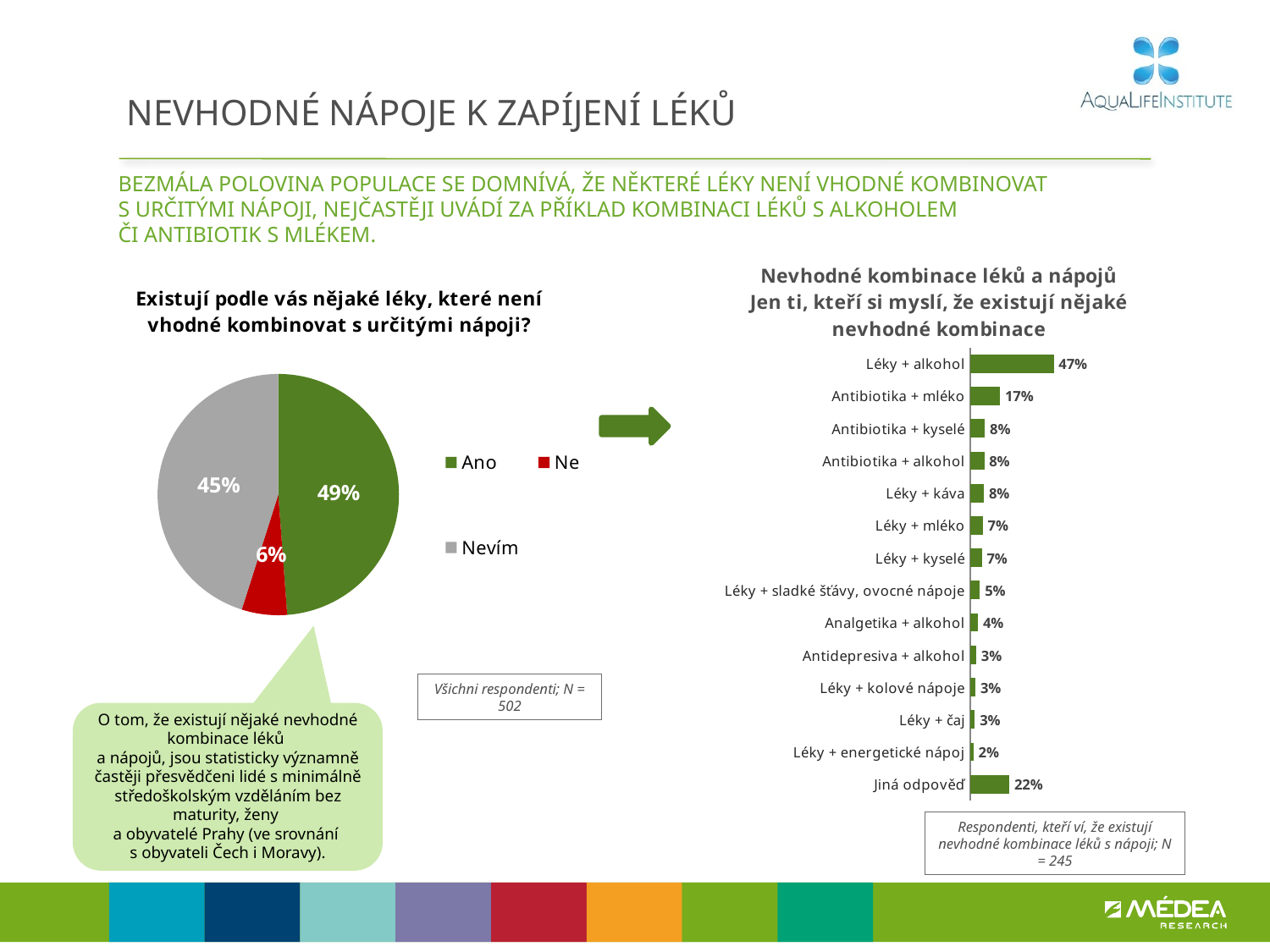
In the pie chart on the left, what share of respondents answered "Ano"? 49% In the bar chart on the right, which is larger: "Léky + káva" or "Léky + mléko"? Léky + káva In the bar chart on the right, what is the difference between "Léky + alkohol" and "Antibiotika + mléko"? 30 percentage points In the bar chart on the right, how many categories are shown? 14 In the pie chart on the left, what share of respondents answered "Nevím"? 45% In the bar chart on the right, what is the value for "Léky + alkohol"? 47% In the bar chart on the right, what is the value for "Jiná odpověď"? 22% In the pie chart on the left, which answer has the smallest share? Ne In the bar chart on the right, which category has the highest value? Léky + alkohol In the pie chart on the left, how many answer categories does the legend list? 3 In the bar chart on the right, which category has the lowest value? Léky + energetické nápoj In the bar chart on the right, what is the value for "Antibiotika + mléko"? 17%